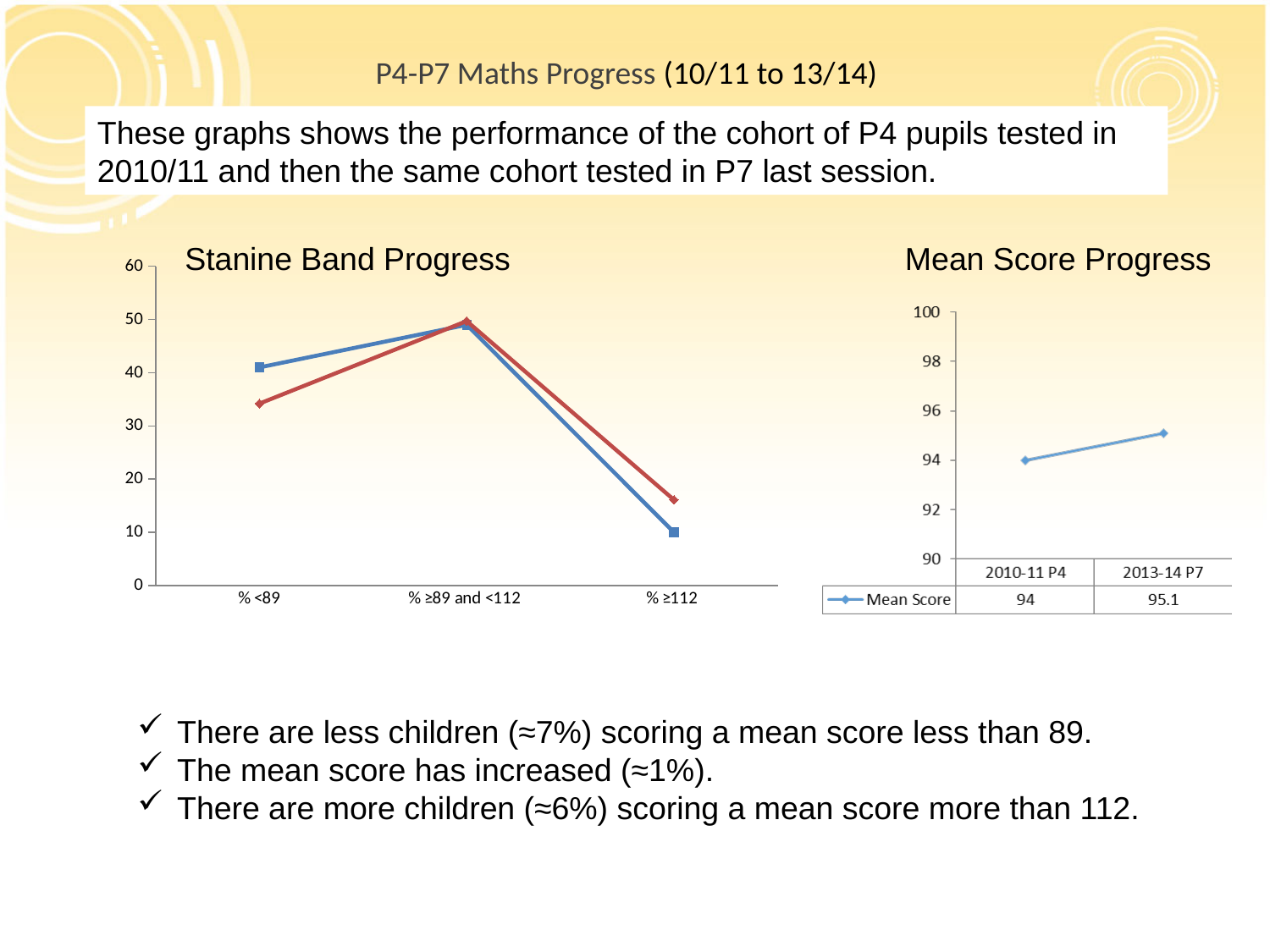
In the Mean Score Progress chart, what is the mean score for 2013-14 P7? 95.1 How many series does the legend of the Mean Score Progress chart list? 1 In the Stanine Band Progress chart, is the value of the red line for "% ≥112" greater or less than 20? less In the Stanine Band Progress chart, which category has the highest value for the blue line? % ≥89 and <112 In the Mean Score Progress chart, what is the difference between the 2013-14 P7 and 2010-11 P4 mean scores? 1.1 In the Mean Score Progress chart, what is the mean score for 2010-11 P4? 94 In the Mean Score Progress chart, does the mean score rise or fall from 2010-11 P4 to 2013-14 P7? rise How many data points are plotted in the Mean Score Progress chart? 2 What kind of chart is the Stanine Band Progress chart? line chart How many categories are shown on the x axis of the Stanine Band Progress chart? 3 In the Stanine Band Progress chart, is the value of the red line for "% <89" greater or less than 40? less In the Mean Score Progress chart, which is higher, the 2010-11 P4 mean score or the 2013-14 P7 mean score? 2013-14 P7